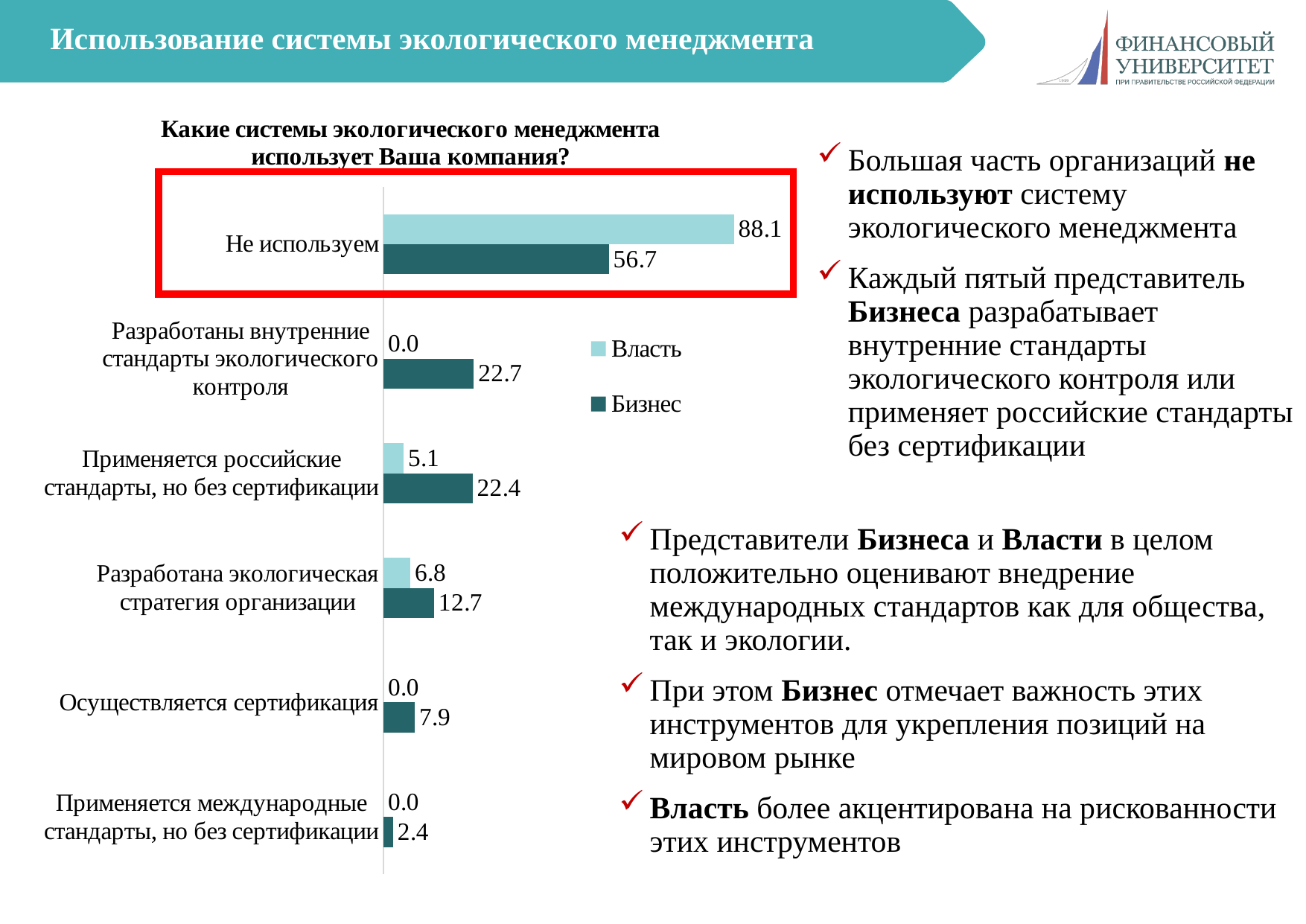
How many categories are shown on the chart? 6 How many series does the legend list? 2 What is the difference between the Власть and Бизнес values in the category "Не используем"? 31.4 What is the value for Власть in the category "Применяется российские стандарты, но без сертификации"? 5.1 In the category "Разработана экологическая стратегия организации", which series has the larger value, Власть or Бизнес? Бизнес What is the value for Бизнес in the category "Осуществляется сертификация"? 7.9 What type of chart is shown on the slide? Bar chart What is the value for Власть in the category "Не используем"? 88.1 What is the value for Бизнес in the category "Не используем"? 56.7 Which category has the lowest value for the Бизнес series? Применяется международные стандарты, но без сертификации What is the value for Бизнес in the category "Разработаны внутренние стандарты экологического контроля"? 22.7 Which category has the highest value for the Бизнес series? Не используем